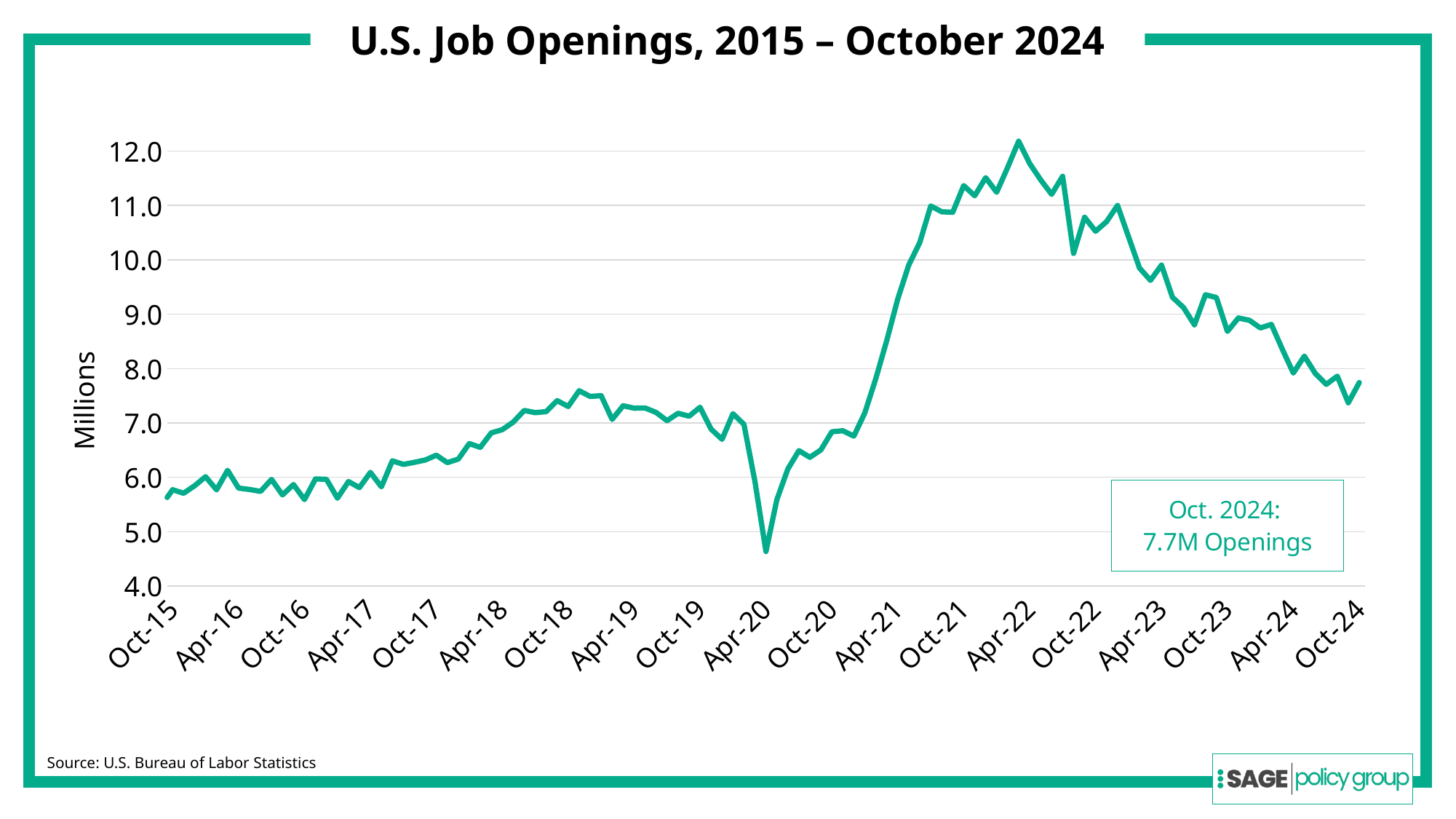
What unit is shown on the y axis label? Millions Between Apr-20 and Oct-21, do job openings rise or fall? rise Is the value for Apr-20 greater or less than 5.0 million? less Around which labeled date on the x axis does the line reach its lowest point? Apr-20 Is the value for Oct-18 greater or less than 7.0 million? greater Is the value for Oct-15 greater or less than 6.0 million? less What kind of chart is shown on the slide? Line chart Which is larger, the value for Oct-21 or the value for Oct-23? Oct-21 Between Apr-22 and Oct-24, do job openings rise or fall? fall Around which labeled date on the x axis does the line reach its highest point? Apr-22 What is the value of U.S. job openings for October 2024 according to the callout on the chart? 7.7M Openings